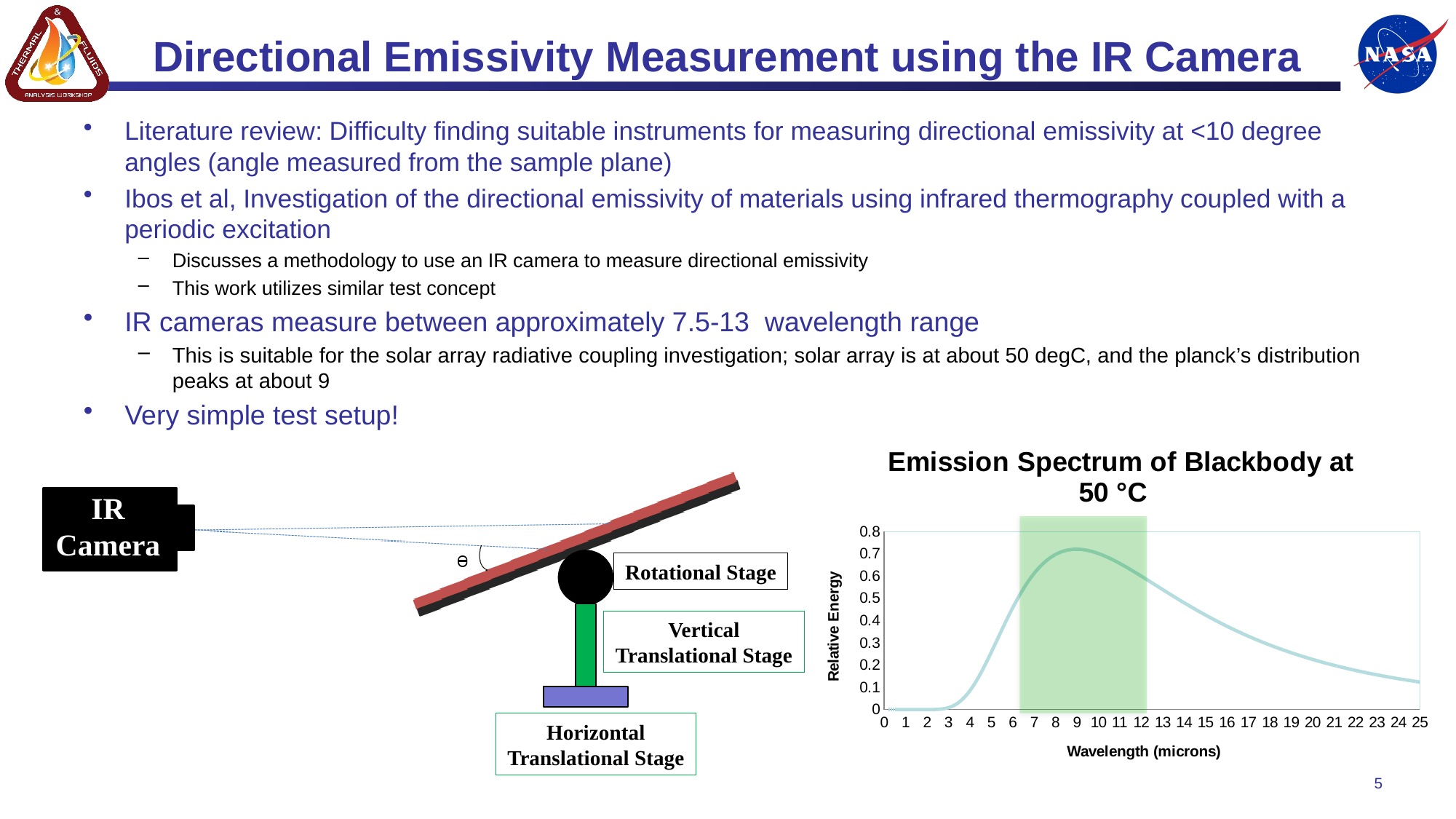
Is the relative energy at a wavelength of 15 microns greater or less than 0.3? greater Does the relative energy rise or fall as wavelength increases from 3 to 8 microns? rise Which wavelength has the higher relative energy, 9 microns or 20 microns? 9 microns What is the title of the chart on the slide? Emission Spectrum of Blackbody at 50 °C Does the relative energy rise or fall as wavelength increases from 9 to 25 microns? fall Is the relative energy at a wavelength of 2 microns greater or less than 0.1? less Is the relative energy at a wavelength of 25 microns greater or less than 0.2? less What kind of chart is the Emission Spectrum of Blackbody at 50 °C? line chart What is the label of the x axis of the chart? Wavelength (microns) What is the highest value shown on the y axis of the chart? 0.8